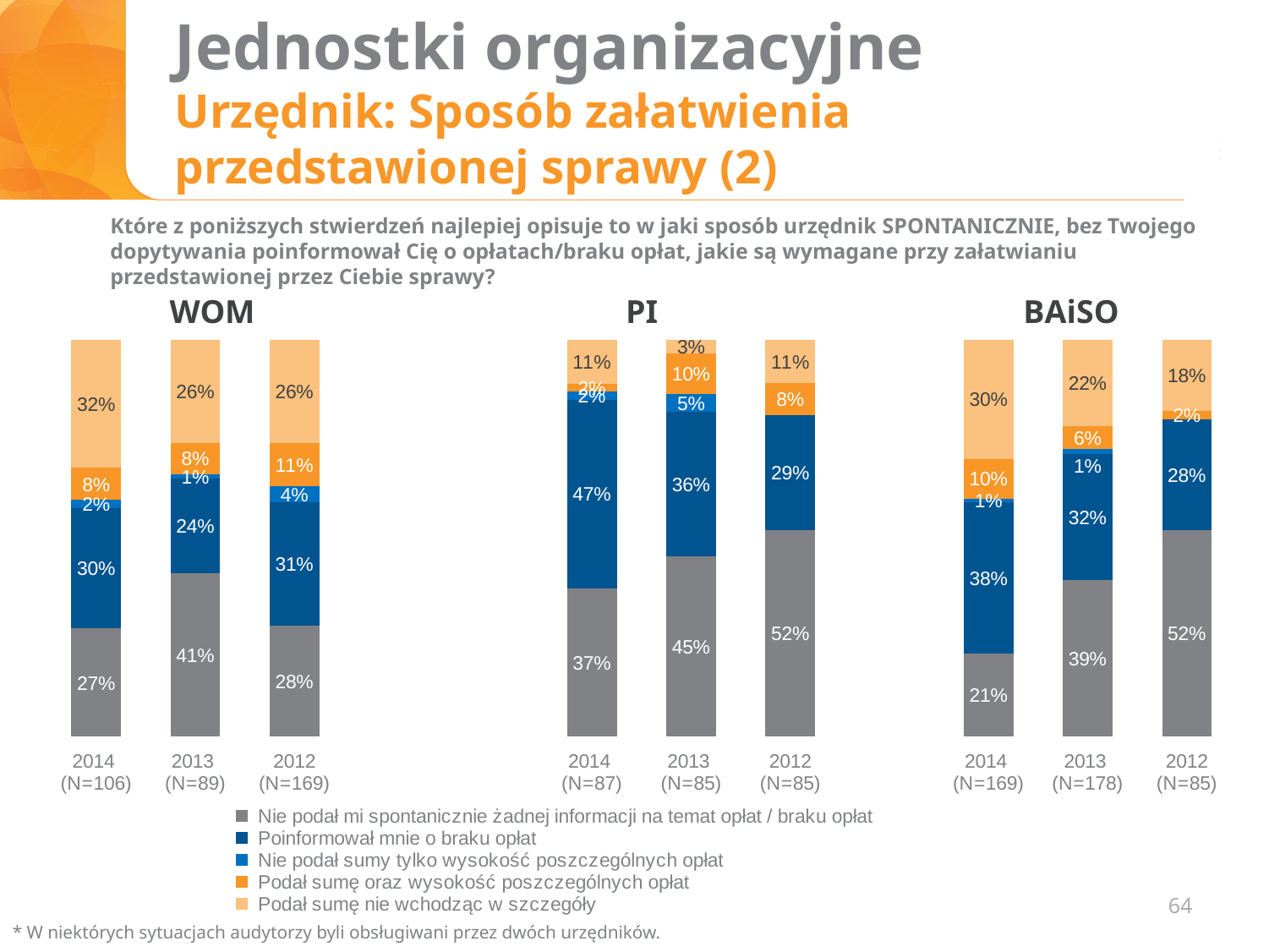
In the PI chart, what is the value for 'Podał sumę oraz wysokość poszczególnych opłat' in 2013? 10% In the BAiSO chart, what is the value for 'Podał sumę nie wchodząc w szczegóły' in 2014? 30% How many bars does the PI chart contain? 3 In the BAiSO chart, which year has the lowest value for 'Nie podał mi spontanicznie żadnej informacji na temat opłat / braku opłat'? 2014 In the BAiSO chart, is the 2013 value for 'Poinformował mnie o braku opłat' larger or smaller than the 2012 value? Larger In the WOM chart, what is the difference between the 2014 and 2013 values for 'Podał sumę nie wchodząc w szczegóły'? 6 percentage points In the WOM chart, what is the value for 'Nie podał mi spontanicznie żadnej informacji na temat opłat / braku opłat' in 2013? 41% In the PI chart, what is the value for 'Poinformował mnie o braku opłat' in 2014? 47% In the PI chart, which year has the highest value for 'Nie podał mi spontanicznie żadnej informacji na temat opłat / braku opłat'? 2012 What is the sample size (N) shown for the 2013 bar in the BAiSO chart? N=178 How many series does the legend list? 5 What kind of chart is used for the WOM, PI and BAiSO data on this slide? Stacked bar chart